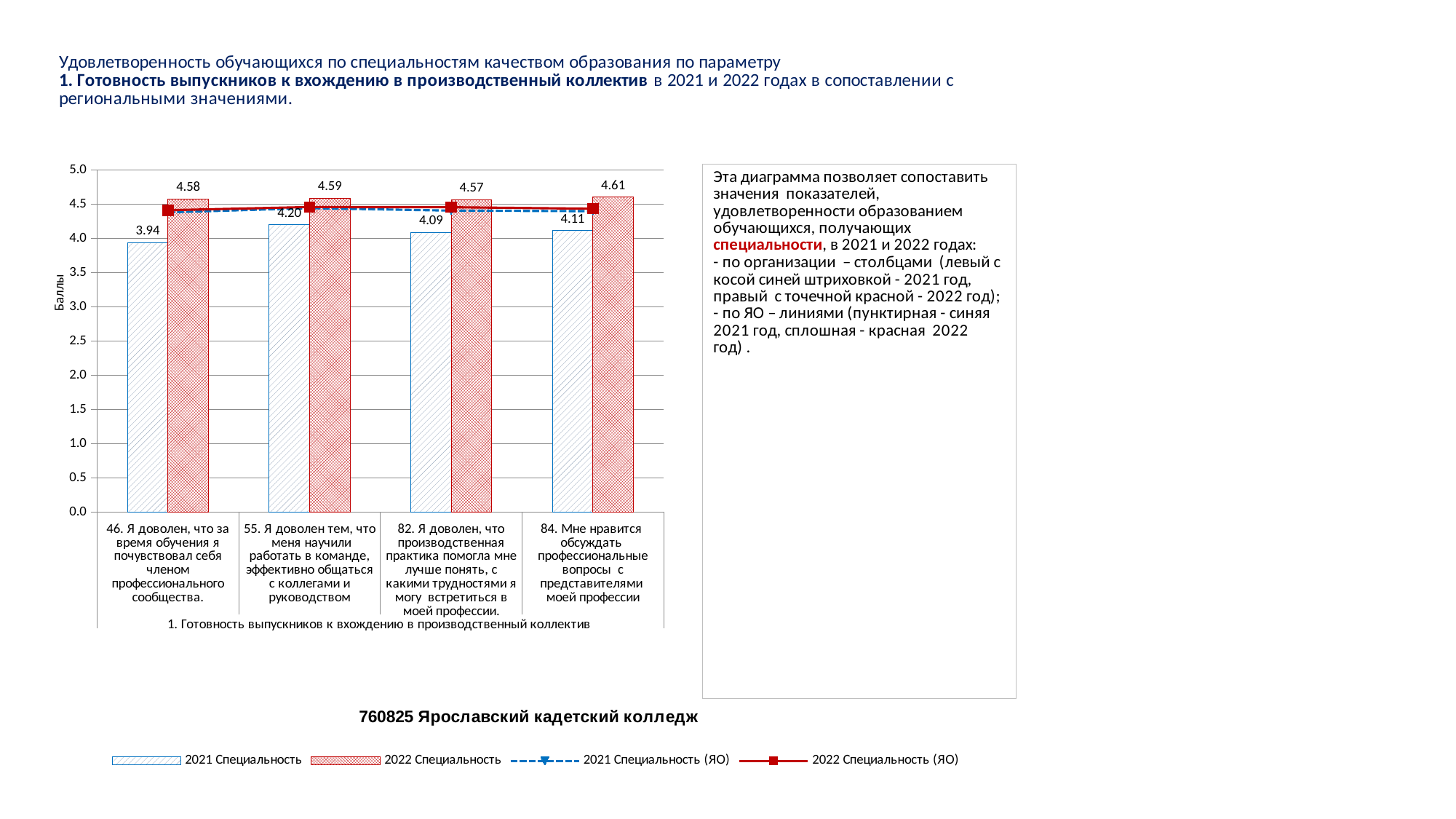
Which category has the highest 2021 Специальность value? 55. Я доволен тем, что меня научили работать в команде, эффективно общаться с коллегами и руководством How many categories are shown on the x axis of the chart? 4 What is the label of the vertical axis of the chart? Баллы What is the value of the 2021 Специальность bar for category 55 (Я доволен тем, что меня научили работать в команде)? 4.20 What is the value of the 2021 Специальность bar for category 46 (Я доволен, что за время обучения я почувствовал себя членом профессионального сообщества)? 3.94 Is the 2021 Специальность (ЯО) line value for category 46 greater or less than 4.0? greater What is the value of the 2022 Специальность bar for category 82 (Я доволен, что производственная практика помогла мне лучше понять...)? 4.57 How many series does the chart legend list? 4 What is the difference between the 2022 and 2021 Специальность values for category 46? 0.64 What is the value of the 2022 Специальность bar for category 84 (Мне нравится обсуждать профессиональные вопросы с представителями моей профессии)? 4.61 Which category has the lowest 2021 Специальность value? 46. Я доволен, что за время обучения я почувствовал себя членом профессионального сообщества. Which is larger for category 82: the 2021 Специальность value or the 2022 Специальность value? 2022 Специальность